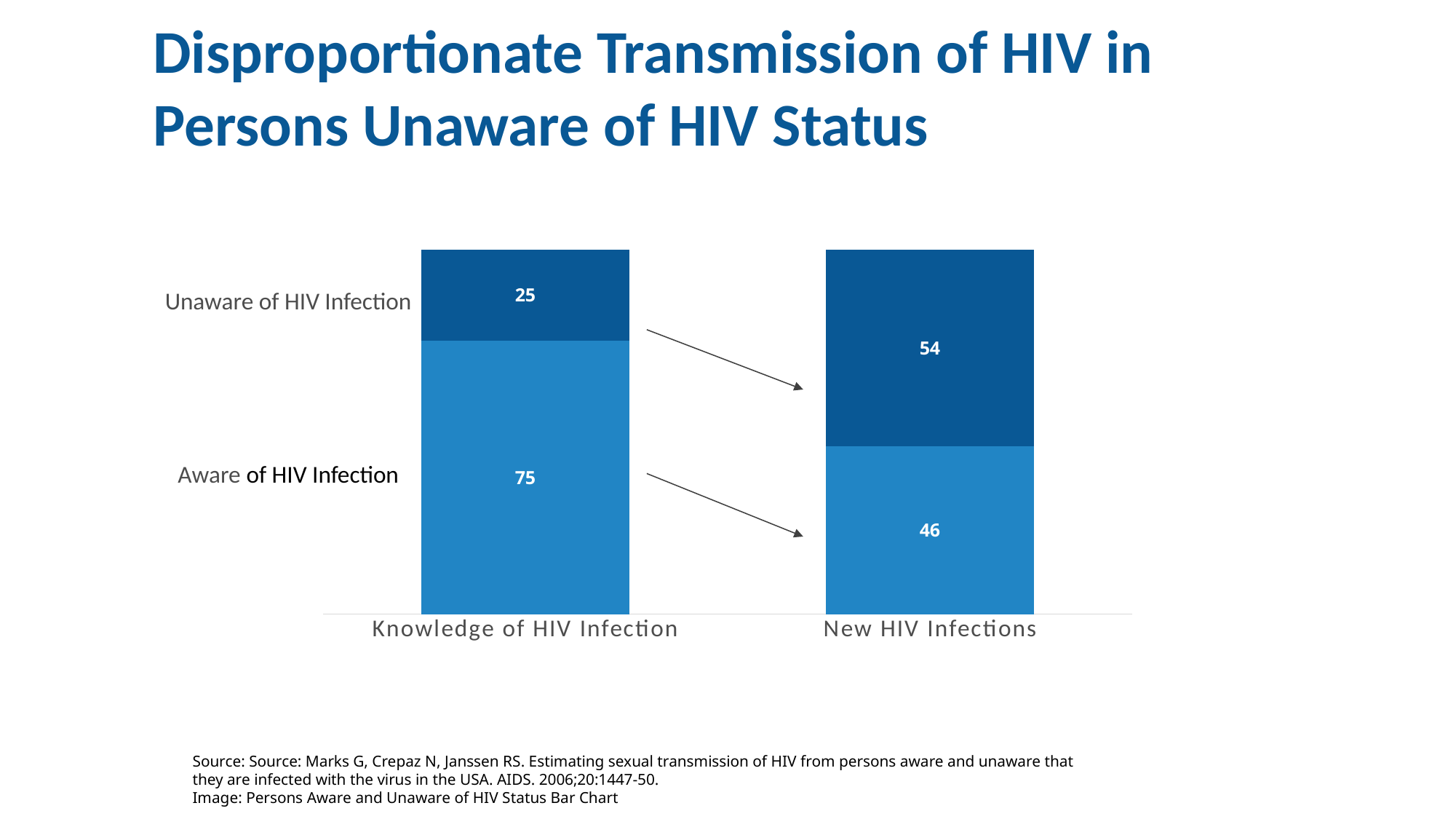
What is the total of the New HIV Infections stacked bar? 100 What is the value for Unaware of HIV Infection in the New HIV Infections bar? 54 What kind of chart is shown on the slide? Stacked bar chart What is the value for Aware of HIV Infection in the Knowledge of HIV Infection bar? 75 How many stacked bars are shown in the chart? 2 What is the difference between the Aware and Unaware values in the Knowledge of HIV Infection bar? 50 What is the difference between the Unaware of HIV Infection values for New HIV Infections and Knowledge of HIV Infection? 29 How many series are shown in the stacked bars? 2 What is the value for Aware of HIV Infection in the New HIV Infections bar? 46 What is the total of the Knowledge of HIV Infection stacked bar? 100 In the New HIV Infections bar, which is larger: Aware of HIV Infection or Unaware of HIV Infection? Unaware of HIV Infection What is the value for Unaware of HIV Infection in the Knowledge of HIV Infection bar? 25